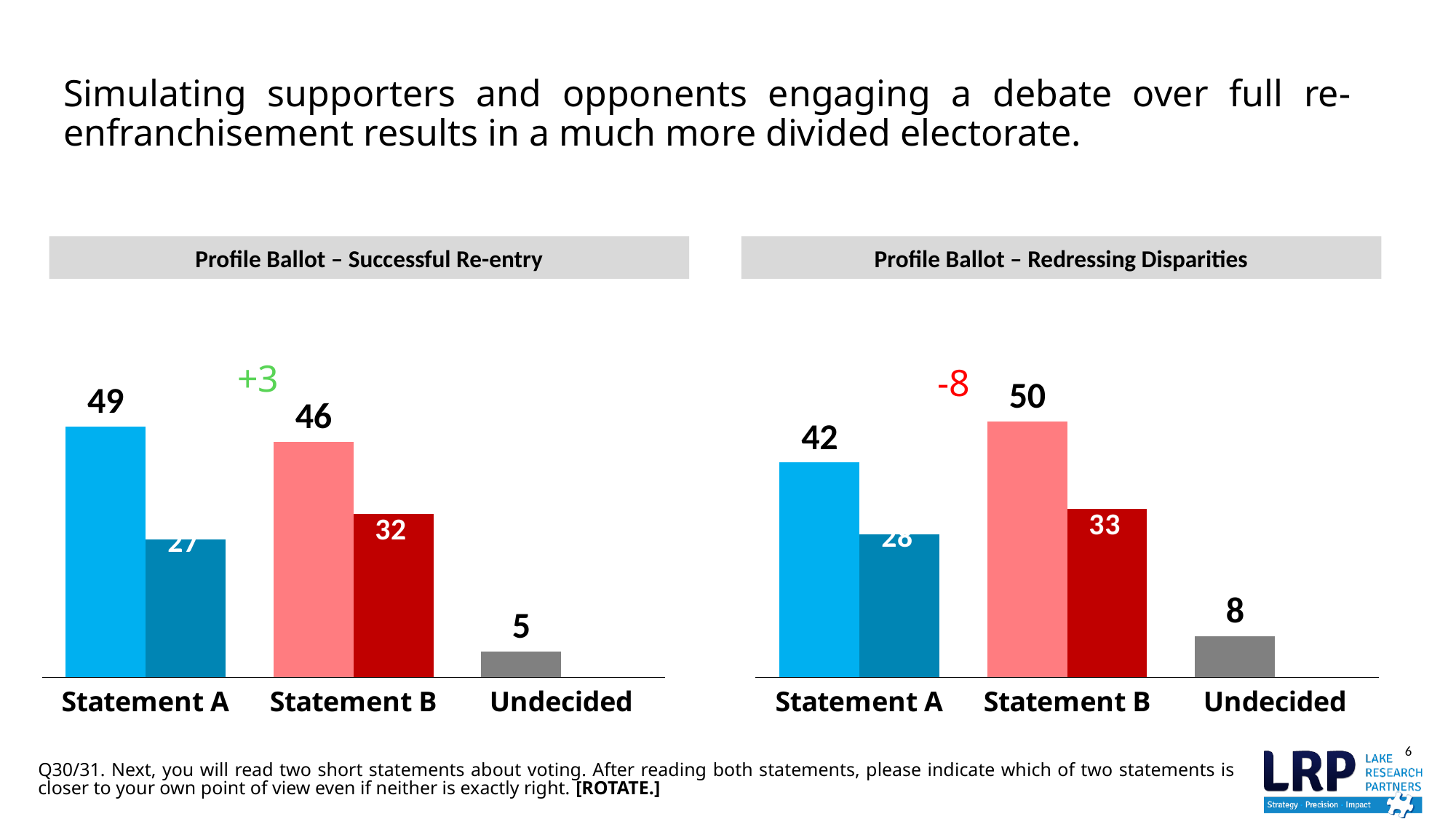
What type of chart is used on this slide? Bar chart In the 'Profile Ballot – Redressing Disparities' chart, which category has the lowest value? Undecided In the 'Profile Ballot – Successful Re-entry' chart, what is the value for Undecided? 5 In the 'Profile Ballot – Successful Re-entry' chart, what is the value of the dark red bar for Statement B? 32 In the 'Profile Ballot – Redressing Disparities' chart, what is the value of the tall bar for Statement A? 42 In the 'Profile Ballot – Successful Re-entry' chart, what is the difference between the tall bars for Statement A and Statement B? 3 In the 'Profile Ballot – Redressing Disparities' chart, what is the value for Undecided? 8 In the 'Profile Ballot – Successful Re-entry' chart, what is the value of the tall bar for Statement B? 46 In the 'Profile Ballot – Redressing Disparities' chart, what is the value of the dark red bar for Statement B? 33 In the 'Profile Ballot – Redressing Disparities' chart, what is the value of the tall bar for Statement B? 50 In the 'Profile Ballot – Redressing Disparities' chart, which is larger, the tall bar for Statement A or the tall bar for Statement B? Statement B In the 'Profile Ballot – Successful Re-entry' chart, what is the value of the tall bar for Statement A? 49